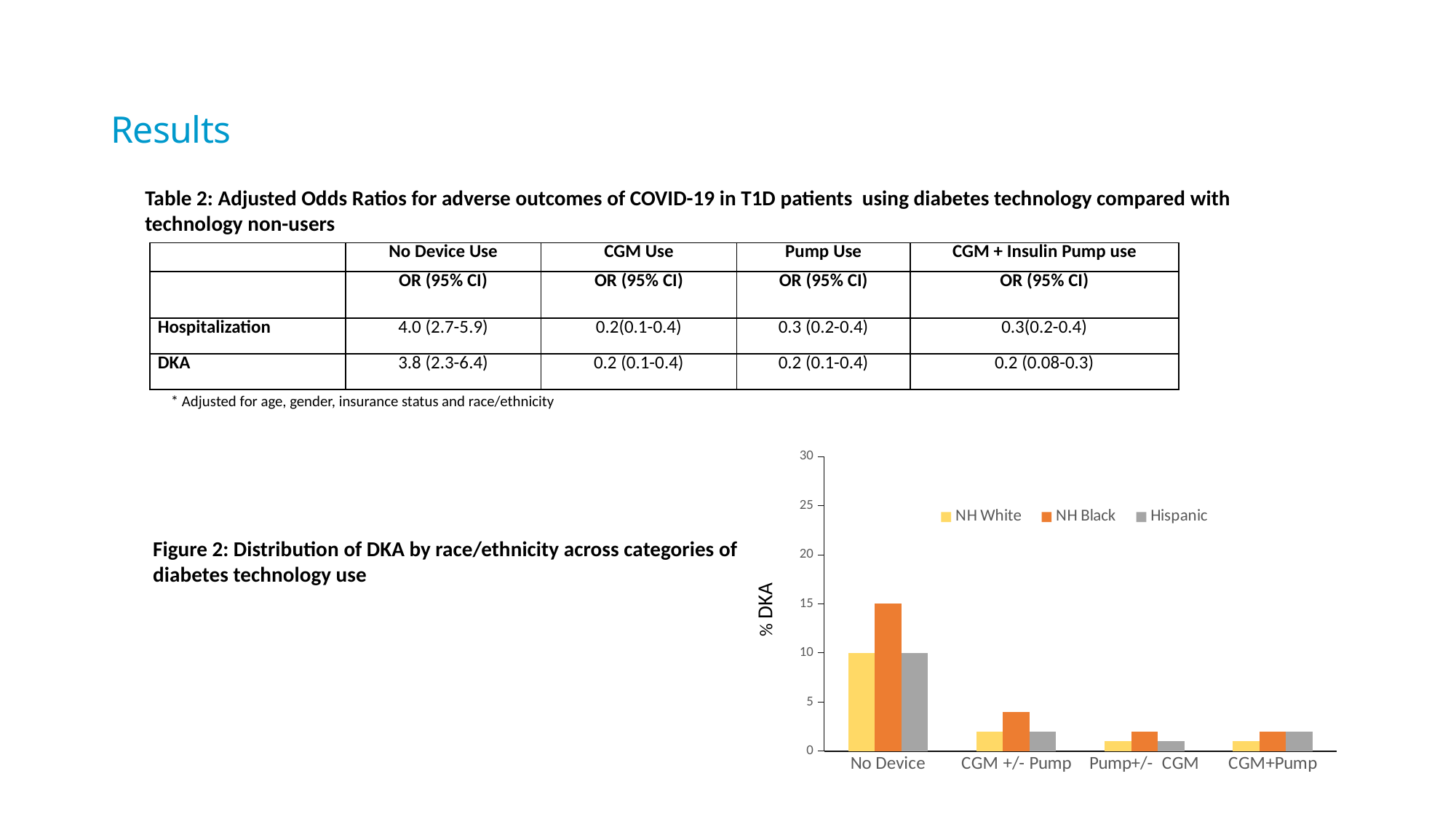
How many categories are shown on the x axis of the Figure 2 chart? 4 In the Figure 2 chart, which is larger for NH Black: the % DKA for No Device or for Pump+/- CGM? No Device What kind of chart is shown in Figure 2? bar chart In the Figure 2 chart, is the % DKA for NH Black in the CGM +/- Pump category greater or less than 5? less How many series does the legend of the Figure 2 chart list? 3 In the Figure 2 chart, is the % DKA for NH White in the No Device category greater or less than 5? greater In the Figure 2 chart, which series is shown in orange? NH Black What is the y-axis label of the Figure 2 chart? % DKA In the Figure 2 chart, which is larger in the CGM +/- Pump category: the % DKA for NH Black or for NH White? NH Black In the Figure 2 chart, which race/ethnicity group has the highest % DKA in the No Device category? NH Black In the Figure 2 chart, is the % DKA for NH Black in the No Device category greater or less than 10? greater In the Figure 2 chart, which category has the highest % DKA for NH Black? No Device